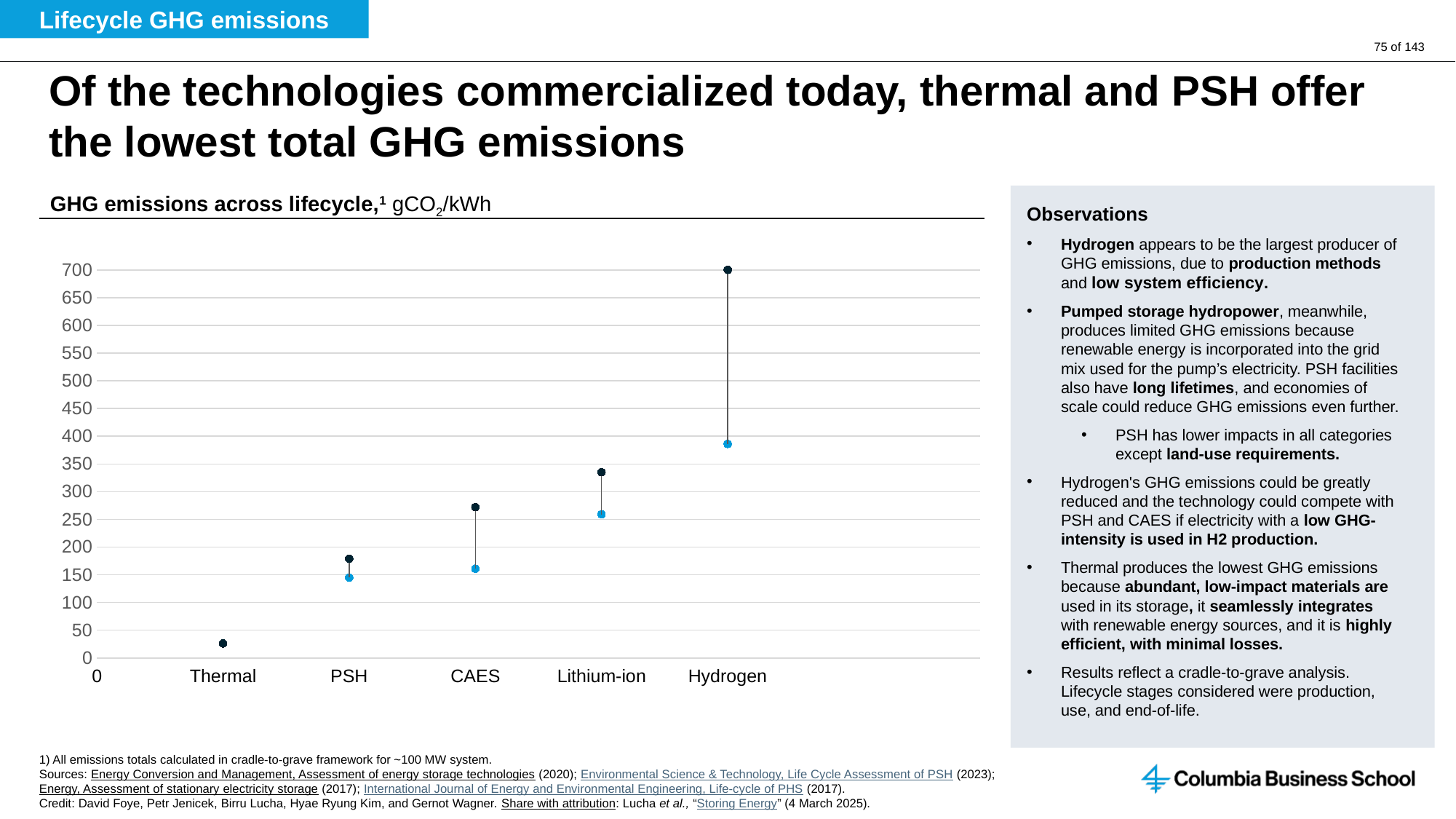
Do the GHG emission values generally rise or fall moving from Thermal to Hydrogen along the x axis? rise Is the lower value for Lithium-ion greater or less than 200? greater How many technologies are plotted on the chart? 5 Which technology has the highest GHG emissions on the chart? Hydrogen Is the lower value for Hydrogen greater or less than 350? greater Is the upper value for PSH greater or less than 200? less Which technology has the lowest GHG emissions on the chart? Thermal What is the highest value shown for Hydrogen? 700 Which has the larger upper value, CAES or Lithium-ion? Lithium-ion What unit is used for the GHG emissions in the chart title? gCO2/kWh